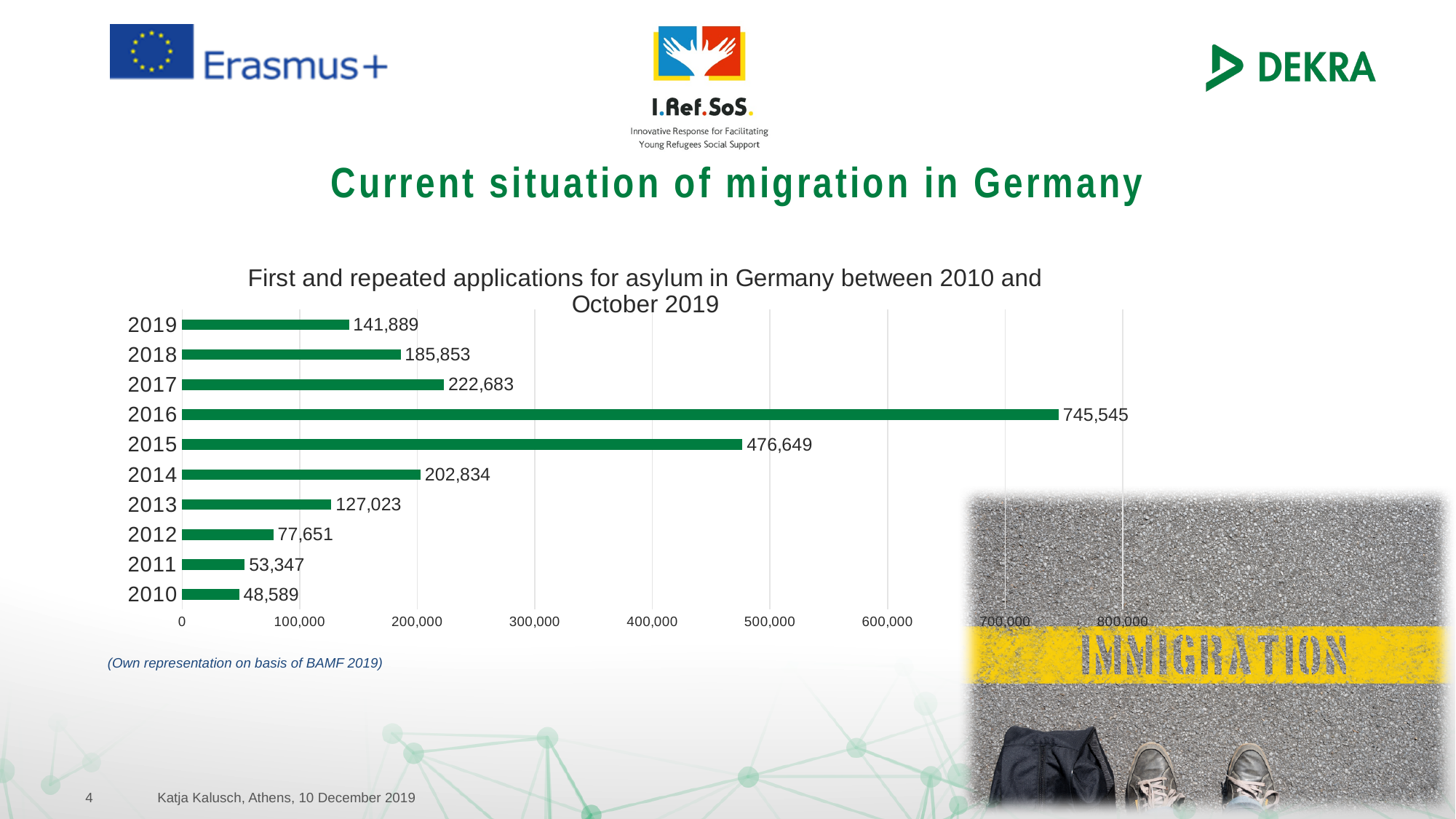
Which year has the highest number of asylum applications? 2016 What is the value for 2016? 745,545 What is the difference between the values for 2011 and 2010? 4,758 What kind of chart is shown on the slide? bar chart What is the difference between the values for 2016 and 2015? 268,896 What is the value for 2010? 48,589 Which year has the lowest number of asylum applications? 2010 How many years are shown in the chart? 10 Is the value for 2015 greater or less than 400,000? greater What is the value for 2019? 141,889 Which is larger, the value for 2014 or the value for 2018? 2014 What is the title of the chart? First and repeated applications for asylum in Germany between 2010 and October 2019